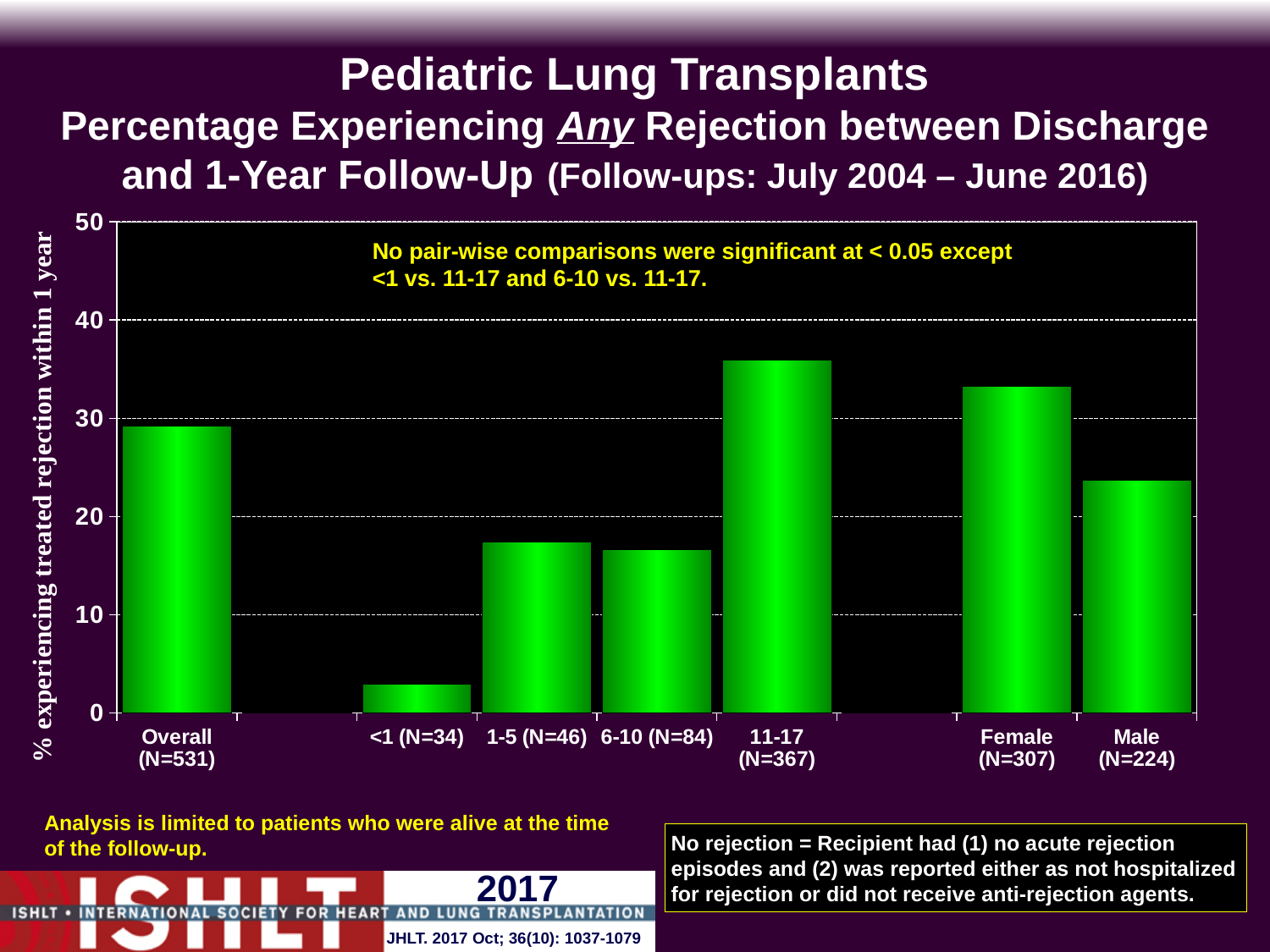
Which has a higher percentage experiencing treated rejection, Female (N=307) or Male (N=224)? Female (N=307) Which category has the highest percentage experiencing treated rejection within 1 year? 11-17 (N=367) Which has a higher percentage experiencing treated rejection, Overall (N=531) or 1-5 (N=46)? Overall (N=531) Is the value for Female (N=307) greater or less than 30? greater What is the label of the y-axis of the chart? % experiencing treated rejection within 1 year Is the value for Overall (N=531) greater or less than 30? less Is the value for Male (N=224) greater or less than 20? greater What kind of chart is shown on the slide? bar chart Which category has the lowest percentage experiencing treated rejection within 1 year? <1 (N=34) How many bars (categories) are plotted in the chart? 7